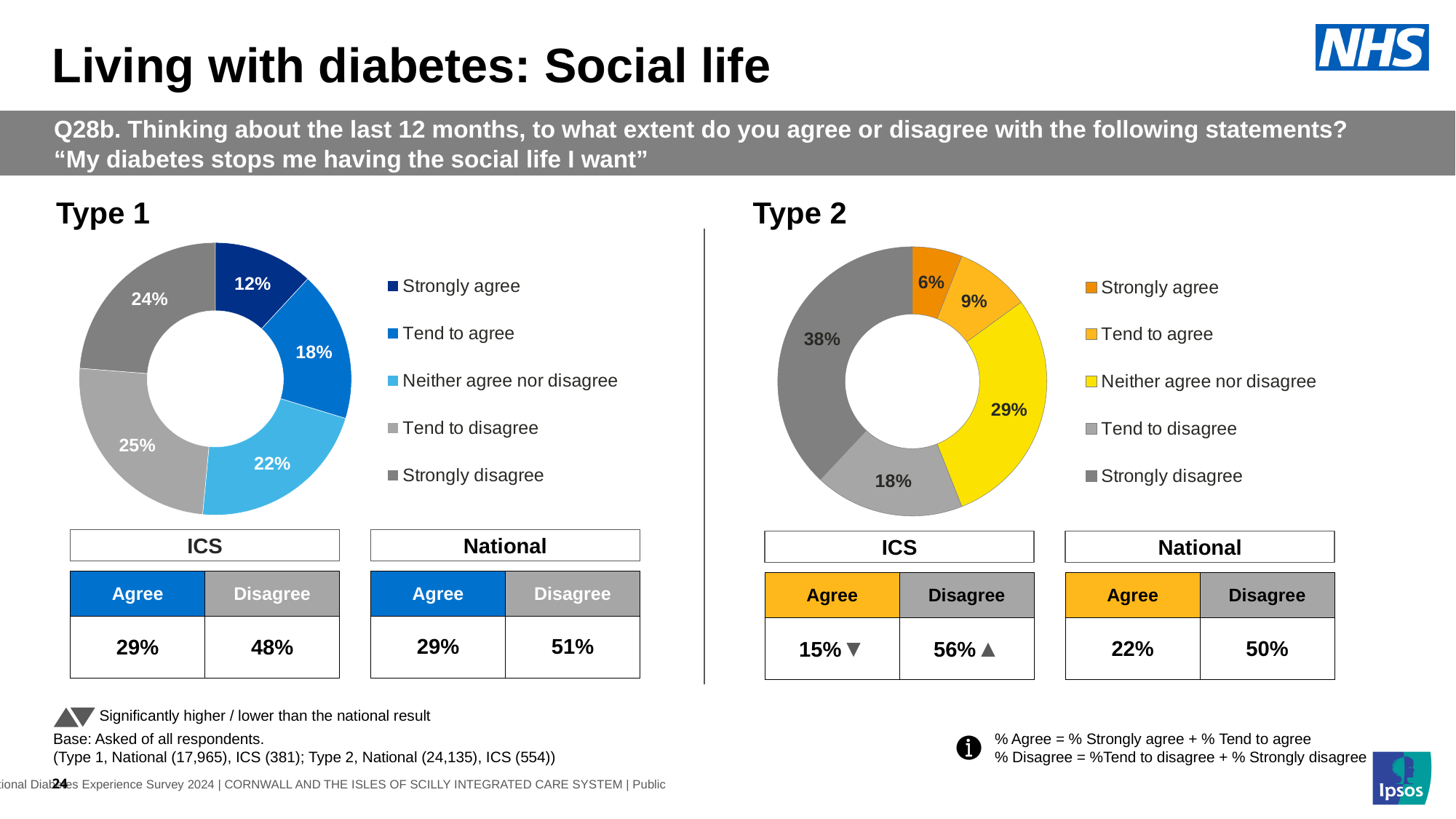
In the Type 1 chart, which is larger: 'Tend to agree' or 'Strongly disagree'? Strongly disagree In the Type 1 chart, what is the combined share of 'Strongly agree' and 'Tend to agree'? 30% In the Type 2 chart, what is the difference between the 'Strongly disagree' and 'Tend to disagree' shares? 20 percentage points In the Type 1 chart, what percentage of respondents said 'Strongly agree'? 12% In the Type 2 chart, what percentage of respondents said 'Tend to agree'? 9% What colour represents 'Neither agree nor disagree' in the Type 2 chart? Yellow In the Type 2 chart, which category has the smallest share? Strongly agree What kind of chart is used for Type 1? Donut (pie) chart In the Type 1 chart, what percentage of respondents said 'Neither agree nor disagree'? 22% How many categories does the Type 2 chart show? 5 In the Type 2 chart, what percentage of respondents said 'Strongly disagree'? 38% In the Type 1 chart, which category has the largest share? Tend to disagree